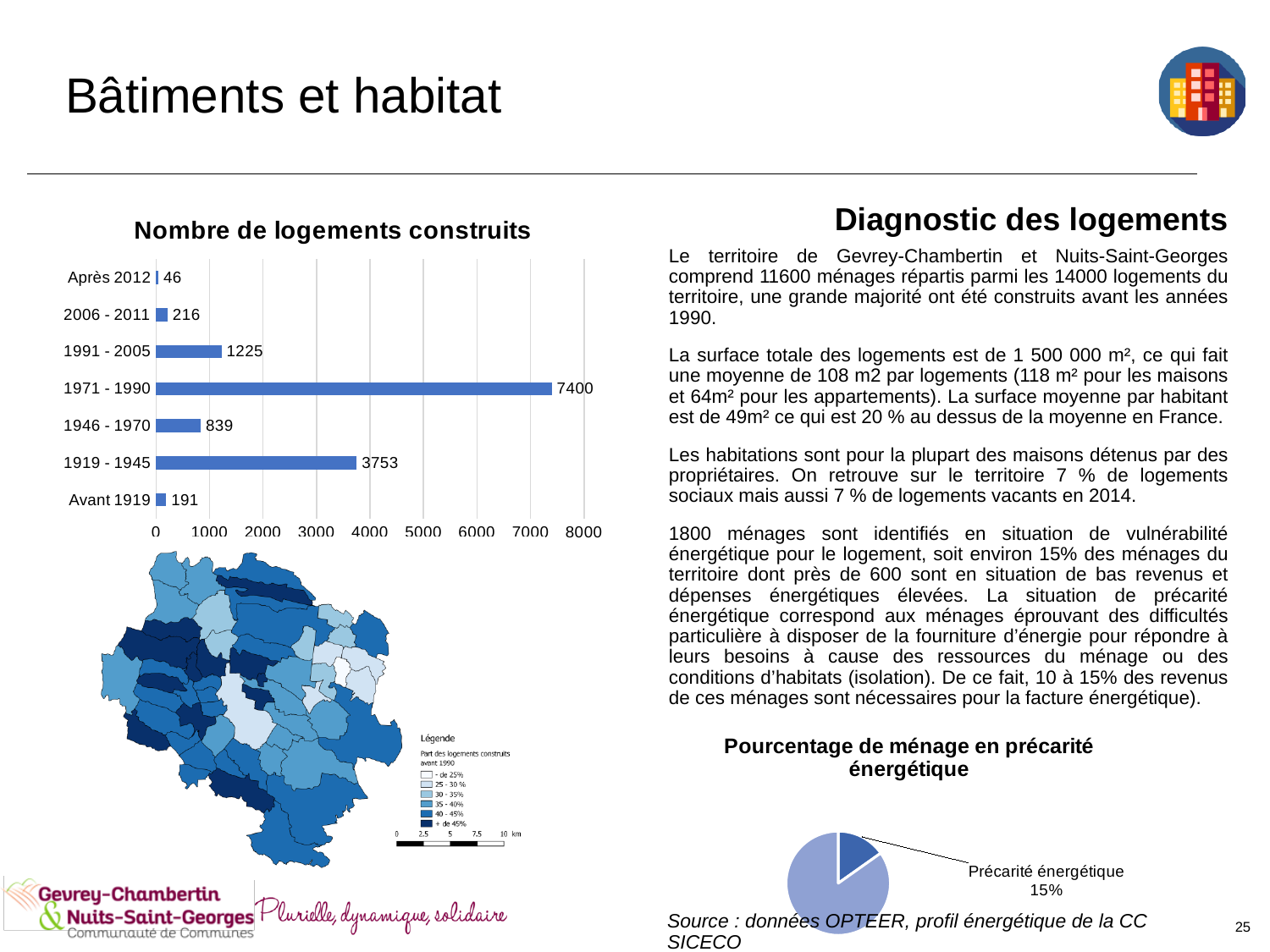
In the 'Nombre de logements construits' chart, what is the value for Après 2012? 46 How many periods are shown in the 'Nombre de logements construits' chart? 7 In the 'Pourcentage de ménage en précarité énergétique' chart, what share is labelled 'Précarité énergétique'? 15% In the 'Nombre de logements construits' chart, what is the difference between the values for 1971 - 1990 and 1919 - 1945? 3647 In the 'Nombre de logements construits' chart, what is the value for 1971 - 1990? 7400 In the 'Nombre de logements construits' chart, which period has the lowest number of dwellings built? Après 2012 What kind of chart is 'Pourcentage de ménage en précarité énergétique'? pie chart What kind of chart is 'Nombre de logements construits'? bar chart In the 'Nombre de logements construits' chart, which is larger: the value for 1946 - 1970 or the value for 1991 - 2005? 1991 - 2005 In the 'Nombre de logements construits' chart, what is the value for 1919 - 1945? 3753 In the 'Nombre de logements construits' chart, is the value for 1946 - 1970 greater or less than 1000? less In the 'Nombre de logements construits' chart, which period has the highest number of dwellings built? 1971 - 1990